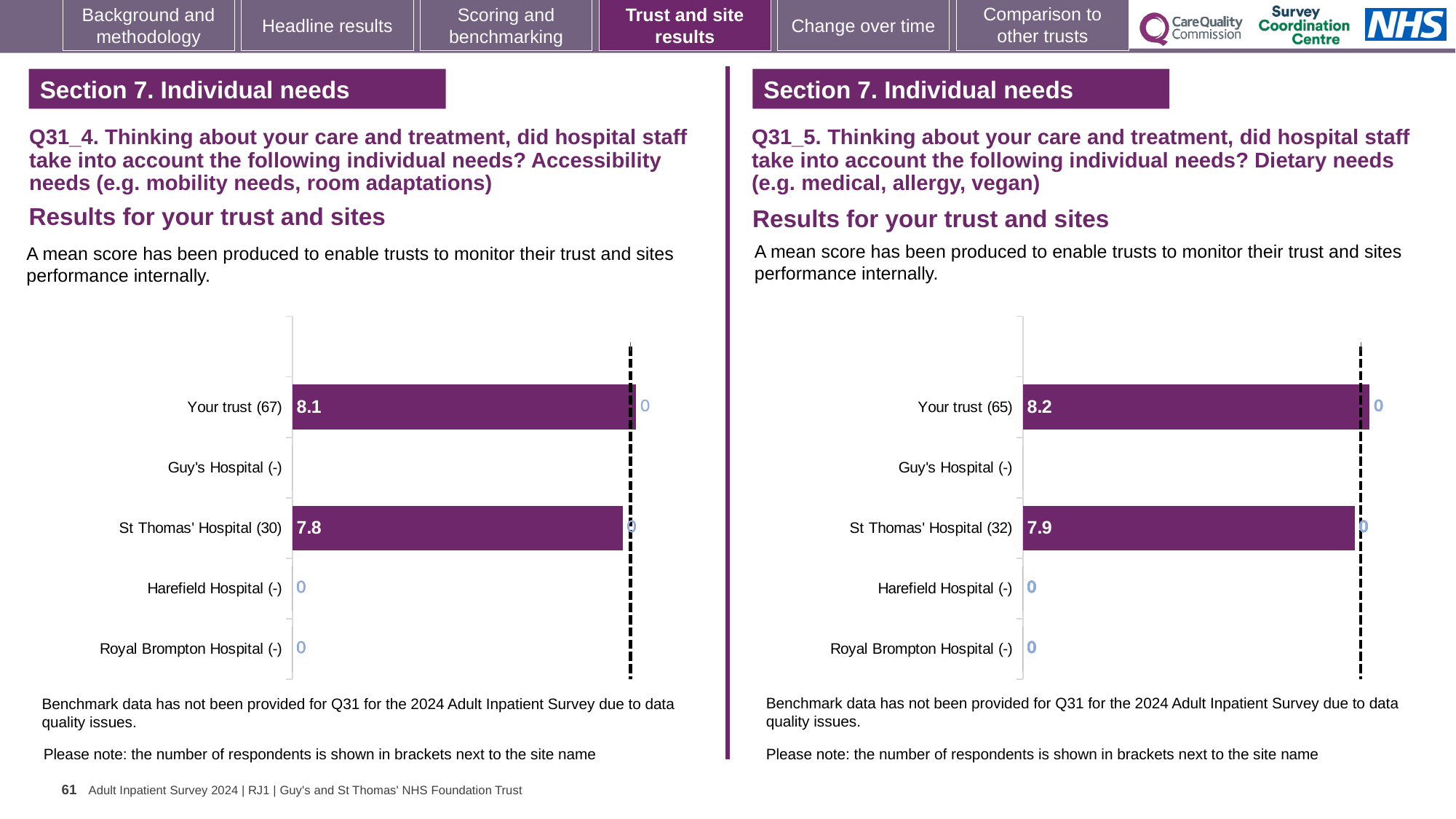
In the Q31_4 chart (left), what is the difference between the scores for Your trust (67) and St Thomas' Hospital (30)? 0.3 In the Q31_5 chart (right), what is the mean score for St Thomas' Hospital (32)? 7.9 In the Q31_5 chart (right), what is the mean score for Your trust (65)? 8.2 In the Q31_4 chart (left), what is the mean score for Your trust (67)? 8.1 What type of chart is used in the Q31_5 chart (right)? Bar chart In the Q31_5 chart (right), how many respondents are shown in brackets for Your trust? 65 In the Q31_4 chart (left), how many respondents are shown in brackets for St Thomas' Hospital? 30 In the Q31_5 chart (right), which has the higher score, Your trust (65) or St Thomas' Hospital (32)? Your trust (65) In the Q31_4 chart (left), what is the mean score for St Thomas' Hospital (30)? 7.8 How many site categories are listed on the y axis of the Q31_4 chart (left)? 5 In the Q31_4 chart (left), which has the higher score, Your trust (67) or St Thomas' Hospital (30)? Your trust (67) In the Q31_5 chart (right), what is the difference between the scores for Your trust (65) and St Thomas' Hospital (32)? 0.3